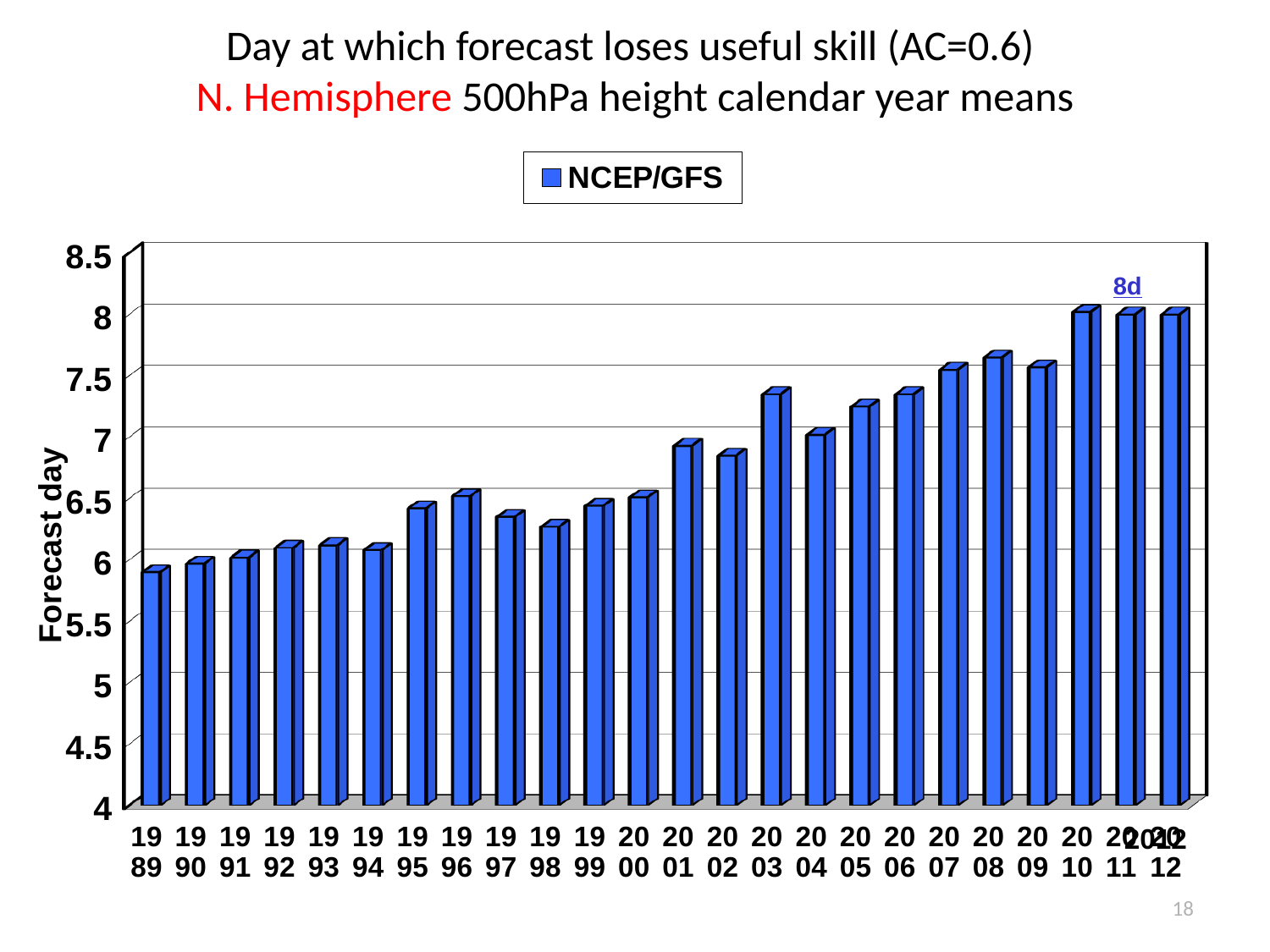
Which year has the larger value, 2008 or 2009? 2008 Do the forecast day values generally rise or fall from 1989 to 2012? rise How many series does the legend list? 1 How many years (bars) are plotted on the chart? 24 Is the value for 2003 greater or less than 7? greater What is the name of the series shown in the legend? NCEP/GFS Which year has the larger value, 2003 or 2004? 2003 What is the label on the vertical axis? Forecast day What kind of chart is shown on the slide? bar chart Which year has the lowest forecast day value? 1989 Is the value for 2004 greater or less than 7.5? less Is the value for 1989 greater or less than 6? less